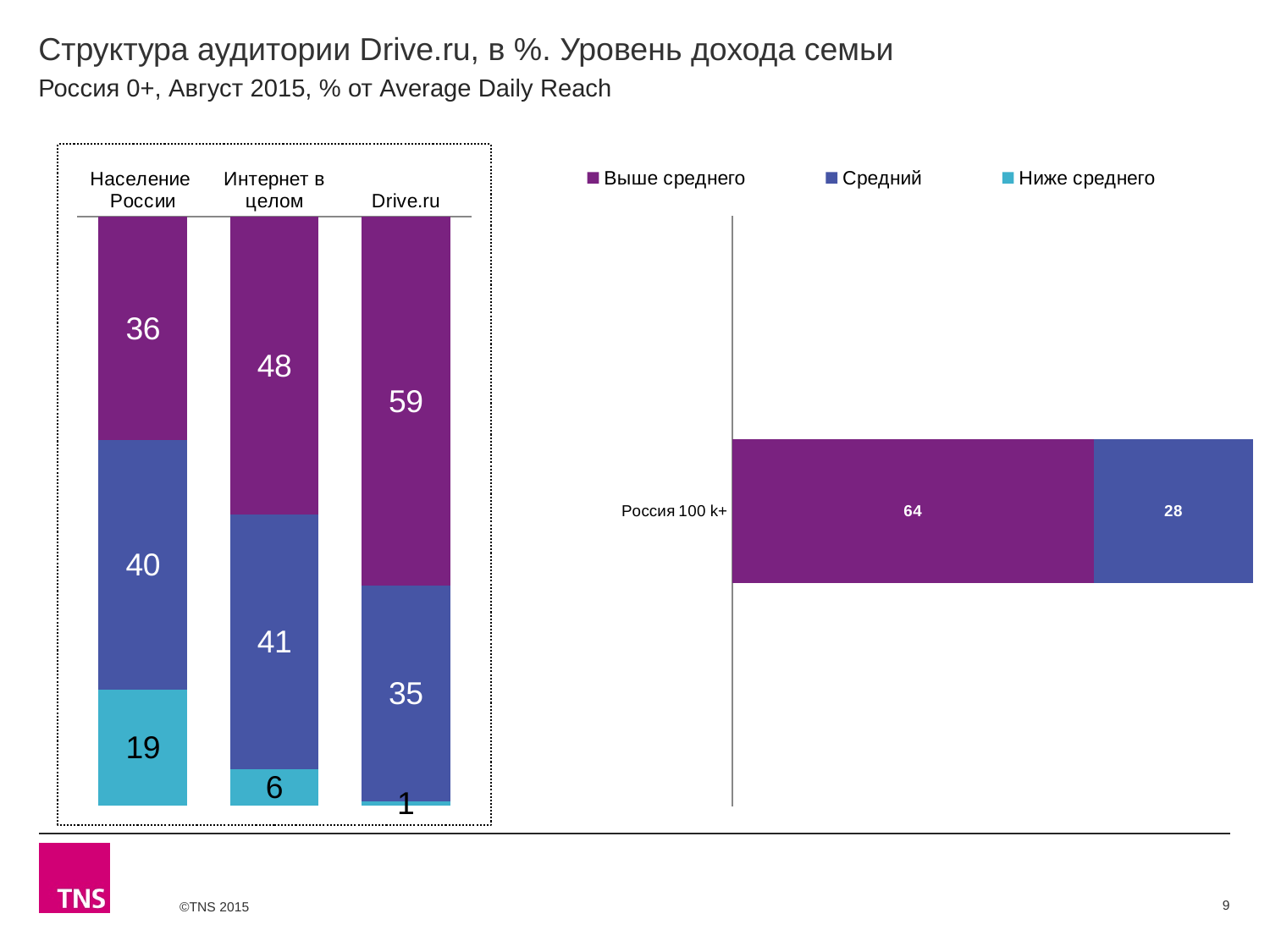
In the left chart, which is larger: the 'Средний' value for 'Население России' or for Drive.ru? Население России In the left chart, what is the value of 'Выше среднего' for Drive.ru? 59 In the left chart, what is the difference between the 'Выше среднего' values for Drive.ru and 'Население России'? 23 In the left chart, what is the value of 'Ниже среднего' for 'Население России'? 19 In the left chart, what is the value of 'Средний' for 'Интернет в целом'? 41 In the right chart, what is the difference between the 'Выше среднего' and 'Средний' values for 'Россия 100 k+'? 36 How many series does the legend list? 3 In the left chart, how many categories are shown on the x axis? 3 In the left chart, which category has the lowest 'Ниже среднего' value? Drive.ru In the right chart, what is the 'Выше среднего' value for 'Россия 100 k+'? 64 In the left chart, which category has the highest 'Выше среднего' value? Drive.ru What kind of chart is the left chart? Stacked bar chart